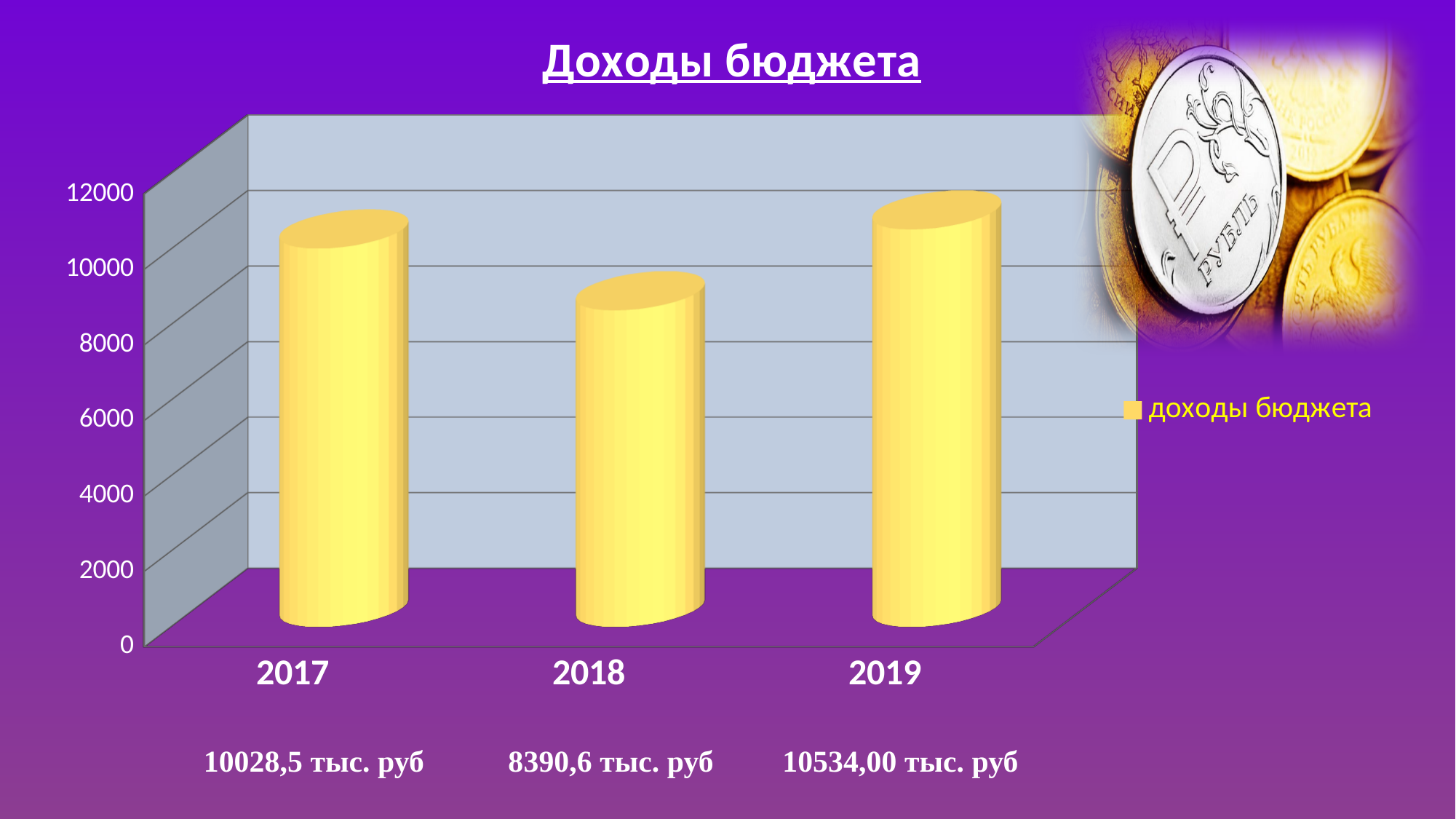
What is the title of the chart? Доходы бюджета What is the difference between the budget revenue in 2017 and in 2018? 1637,9 тыс. руб What is the budget revenue value shown for 2017? 10028,5 тыс. руб How many years are shown on the x axis of the chart? 3 What type of chart is shown on the slide? Bar chart What is the difference between the budget revenue in 2019 and in 2017? 505,5 тыс. руб Which year has the larger budget revenue, 2017 or 2018? 2017 Which year has the lowest budget revenue? 2018 What is the budget revenue value shown for 2018? 8390,6 тыс. руб Which year has the highest budget revenue? 2019 Is the value for 2018 greater or less than 10000? less What is the budget revenue value shown for 2019? 10534,00 тыс. руб